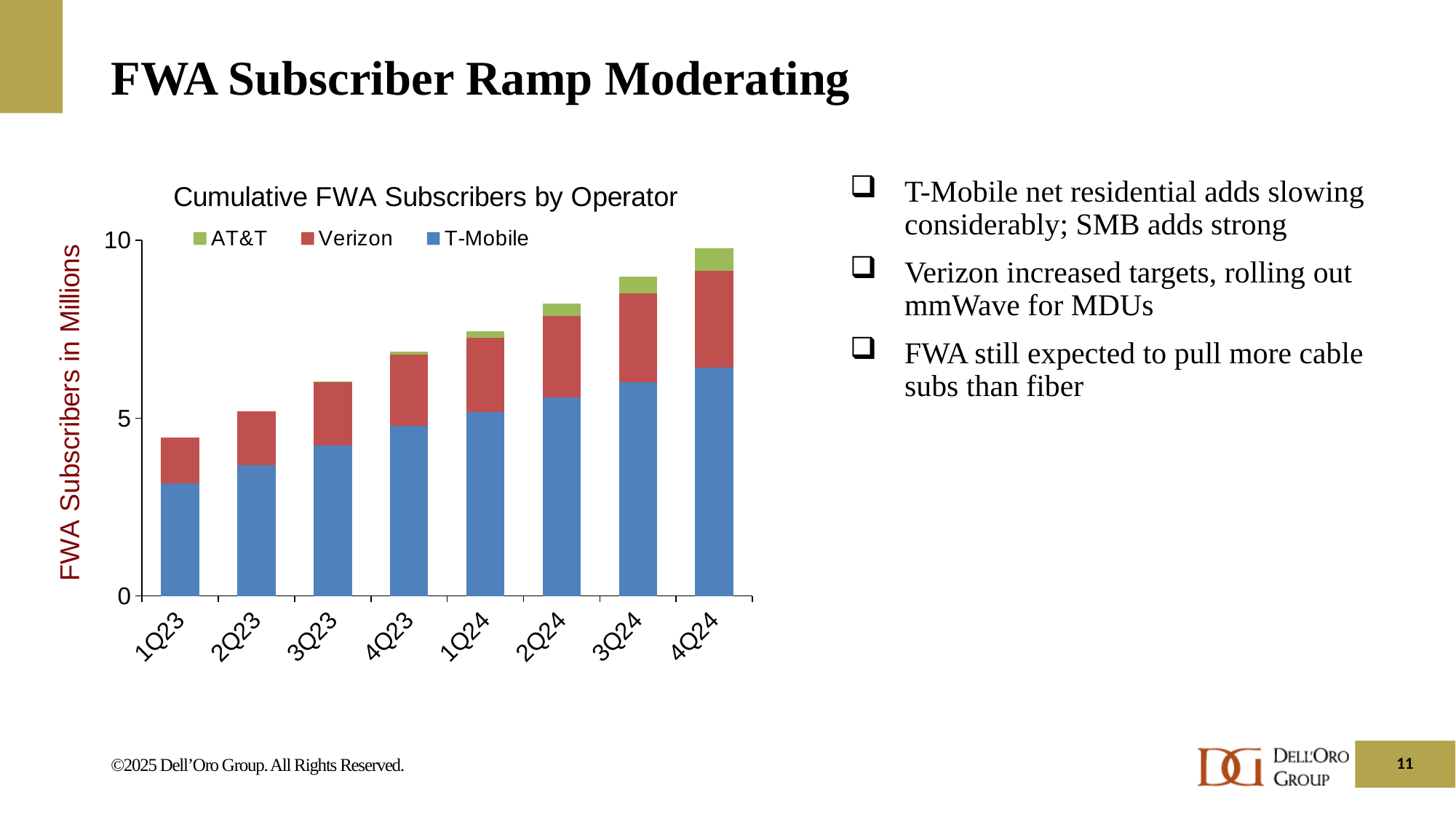
In 4Q24, which operator has more cumulative FWA subscribers, T-Mobile or Verizon? T-Mobile Which quarter has the highest total cumulative FWA subscribers? 4Q24 Is the total value for 1Q23 greater or less than 5? less What is the label on the y axis of the chart? FWA Subscribers in Millions Do total cumulative FWA subscribers rise or fall from 1Q23 to 4Q24? Rise Is the total value for 4Q24 greater or less than 10? less What kind of chart is shown on the slide? Stacked bar chart How many series does the chart's legend list? 3 How many quarters are shown on the x axis of the chart? 8 Is the T-Mobile value for 4Q24 greater or less than 5? greater Which quarter has the lowest total cumulative FWA subscribers? 1Q23 What is the title of the chart? Cumulative FWA Subscribers by Operator